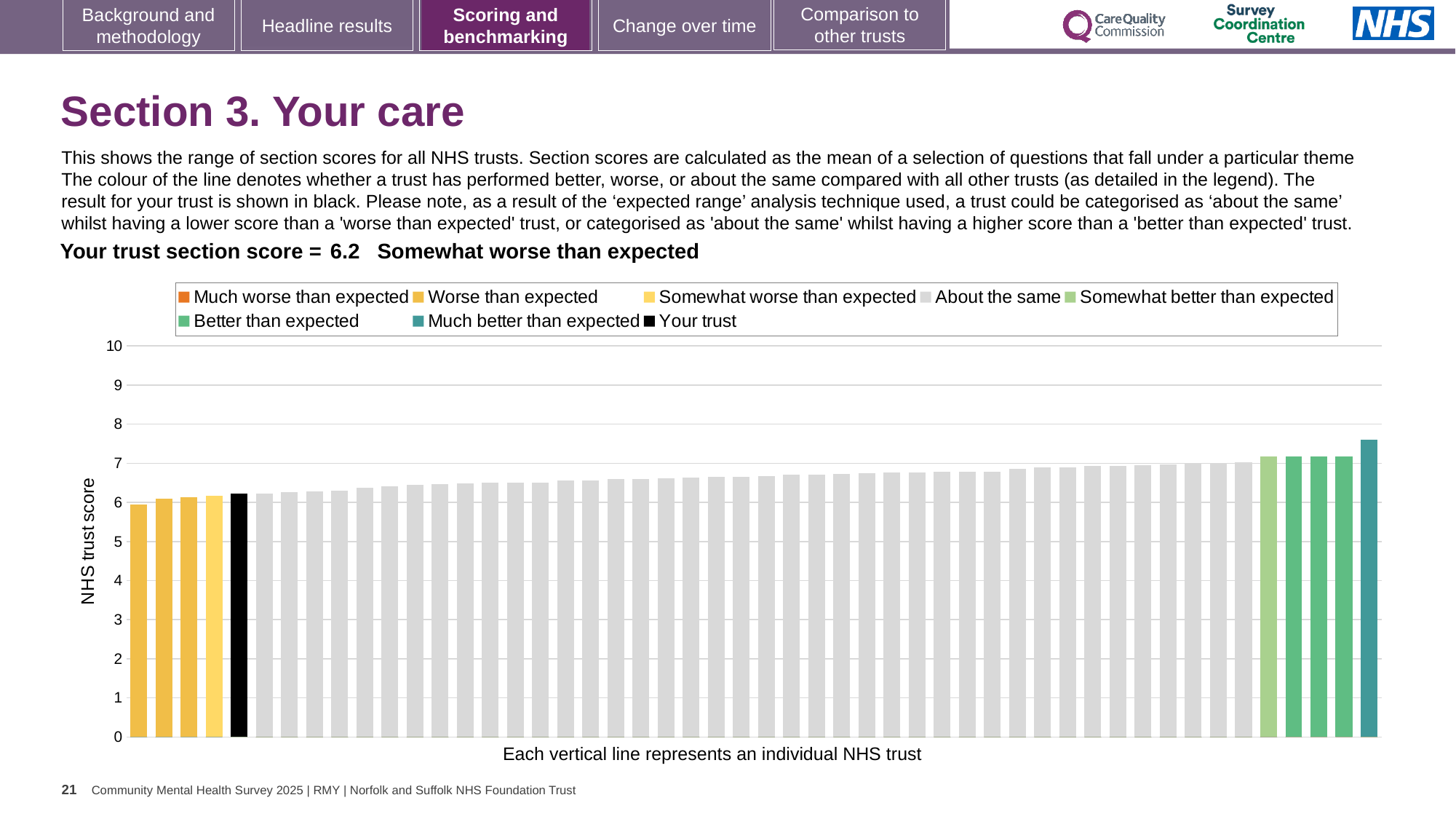
How many yellow bars appear to the left of the black bar? 4 What kind of chart is shown on the slide? Bar chart Is the value for your trust greater or less than 7? less What is the section score for your trust shown on the slide? 6.2 Is your trust's bar higher or lower than the rightmost bar? Lower What is the label on the y axis of the chart? NHS trust score Which bar is the highest on the chart? The rightmost (teal) bar How many entries does the chart legend list? 8 Is the value of the tallest bar greater or less than 7? greater Which category is your trust placed in for this section? Somewhat worse than expected Is the value of the lowest bar greater or less than 5? greater Do the bar values rise or fall from left to right along the x axis? Rise